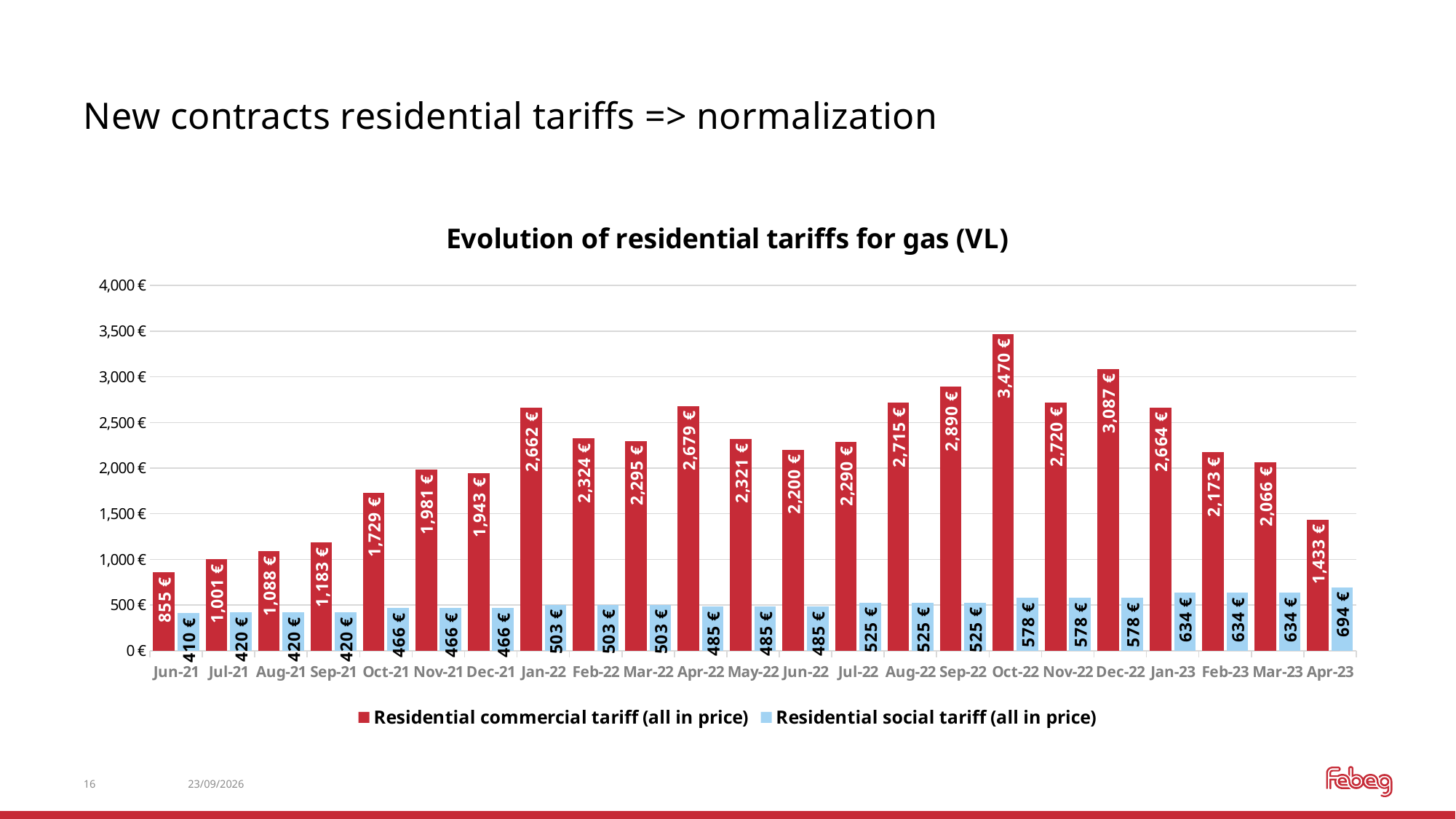
Is the residential commercial tariff for Apr-23 greater or less than 1,500 €? less Does the residential social tariff rise or fall from Jun-21 to Apr-23? rise What is the residential commercial tariff (all in price) for Oct-22? 3,470 € Which month has the higher residential commercial tariff, Jan-22 or Apr-22? Apr-22 What is the difference between the residential social tariff in Apr-23 and in Jun-21? 284 € What is the difference between the residential commercial tariff in Oct-22 and in Dec-22? 383 € What kind of chart is shown on the slide? bar chart How many series does the legend list? 2 In which month is the residential commercial tariff lowest? Jun-21 What is the residential social tariff (all in price) for Apr-23? 694 € How many months are shown on the x axis of the chart? 23 In which month is the residential commercial tariff highest? Oct-22